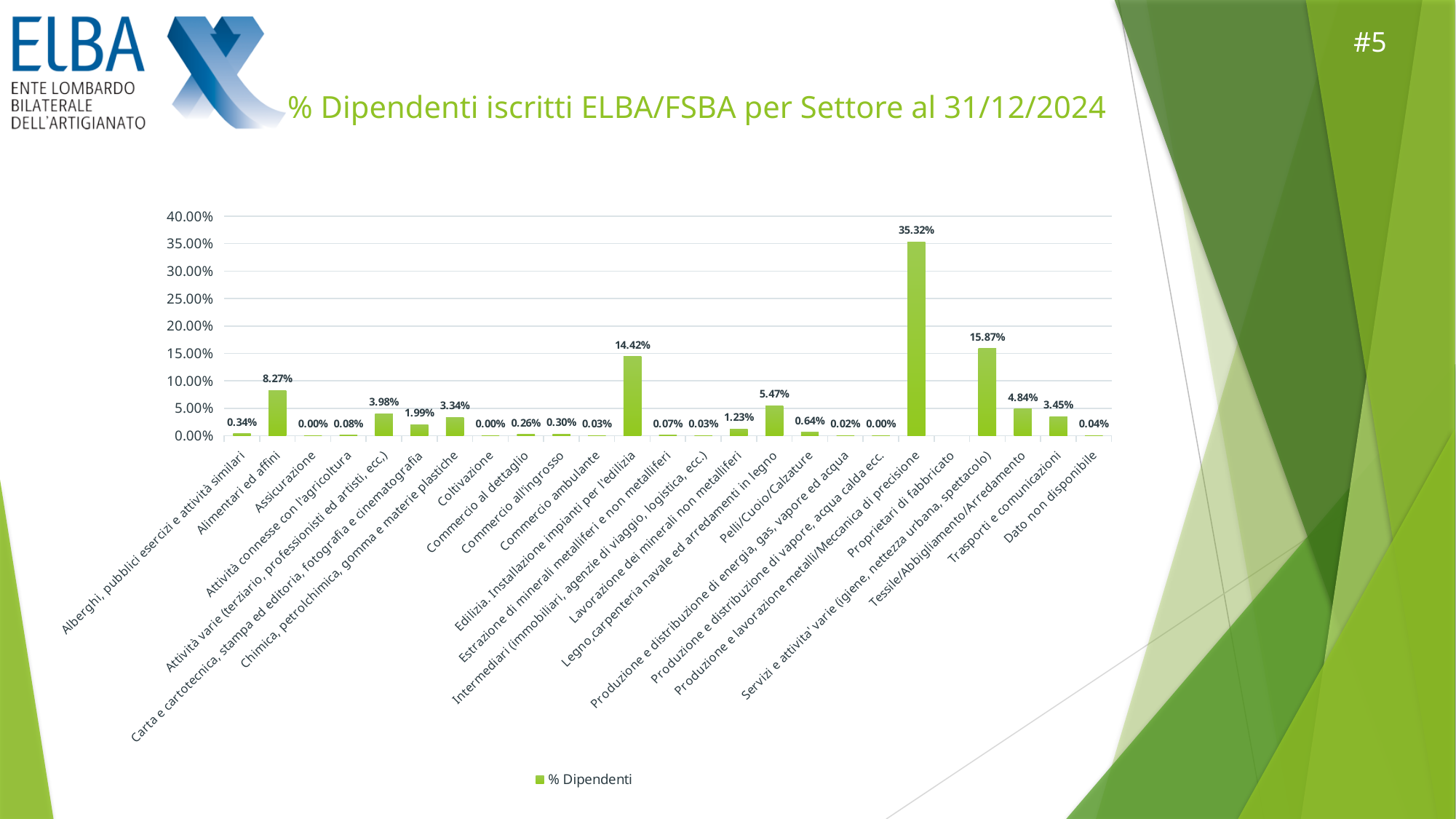
What is the value for Tessile/Abbigliamento/Arredamento? 4.84% Which is larger, Legno, carpenteria navale ed arredamenti in legno or Attività varie (terziario, professionisti ed artisti, ecc.)? Legno, carpenteria navale ed arredamenti in legno What is the value for Alimentari ed affini? 8.27% How many series does the legend list? 1 What is the difference between Servizi e attività varie (igiene, nettezza urbana, spettacolo) and Edilizia. Installazione impianti per l'edilizia? 1.45% How many sector categories are shown on the x axis? 25 What kind of chart is shown on the slide? bar chart Which sector has the highest percentage? Produzione e lavorazione metalli/Meccanica di precisione What is the legend entry of the chart? % Dipendenti What is the value for Edilizia. Installazione impianti per l'edilizia? 14.42% Is the value for Produzione e lavorazione metalli/Meccanica di precisione greater or less than 30.00%? greater What is the value for Produzione e lavorazione metalli/Meccanica di precisione? 35.32%